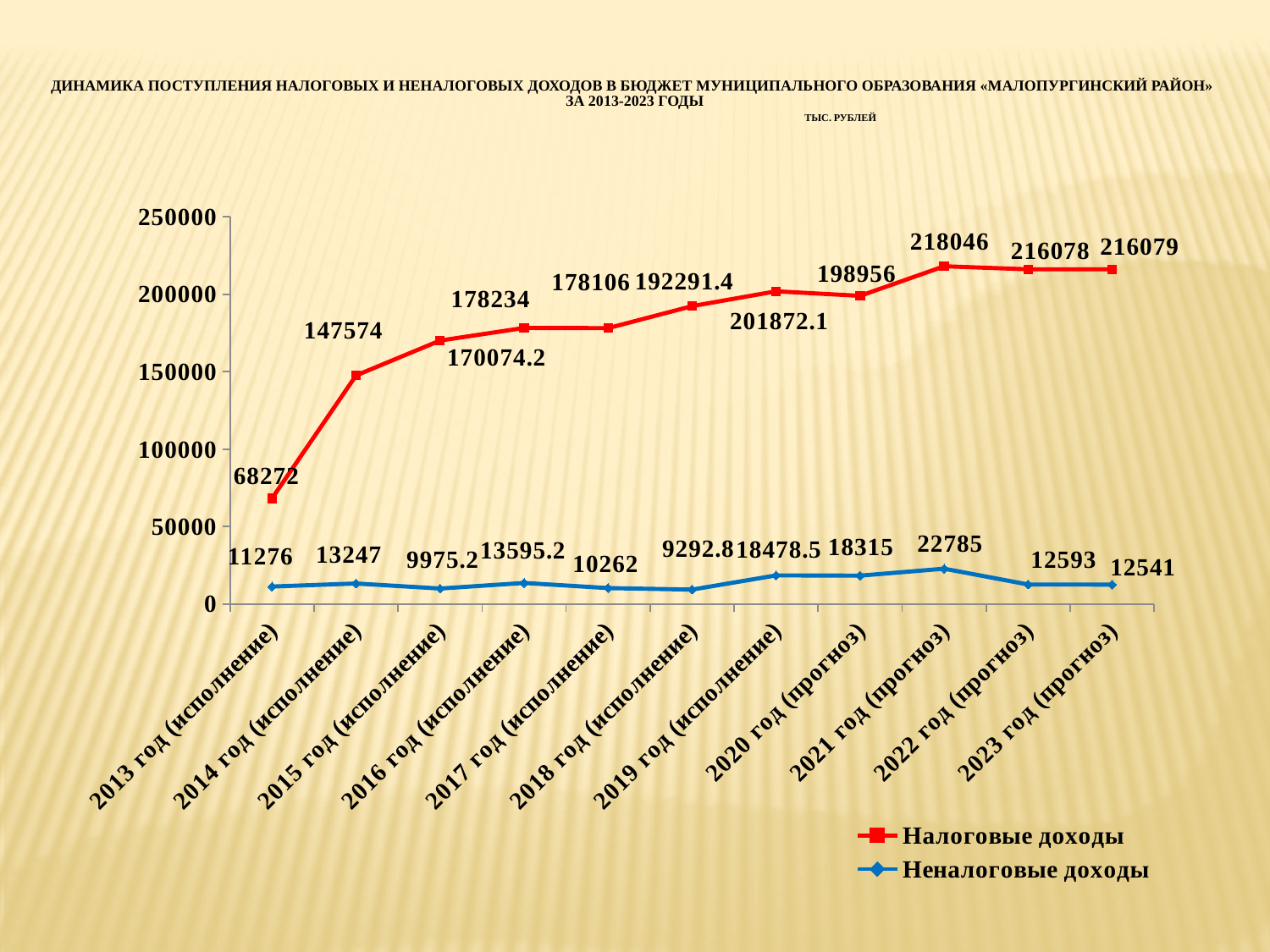
What is the value of Налоговые доходы for 2013 год (исполнение)? 68272 By how much did Налоговые доходы increase from 2013 год (исполнение) to 2014 год (исполнение)? 79302 Is the value of Налоговые доходы for 2018 год (исполнение) greater or less than 150000? greater How many series does the legend list? 2 In which year are Неналоговые доходы the lowest? 2018 год (исполнение) What is the value of Налоговые доходы for 2023 год (прогноз)? 216079 What is the value of Неналоговые доходы for 2019 год (исполнение)? 18478.5 Which is larger for 2021 год (прогноз): Налоговые доходы or Неналоговые доходы? Налоговые доходы What type of chart is shown on the slide? line chart Which colour is used for the Неналоговые доходы line? blue In which year do Налоговые доходы reach their highest value? 2021 год (прогноз) How many years (categories) are plotted along the x axis? 11